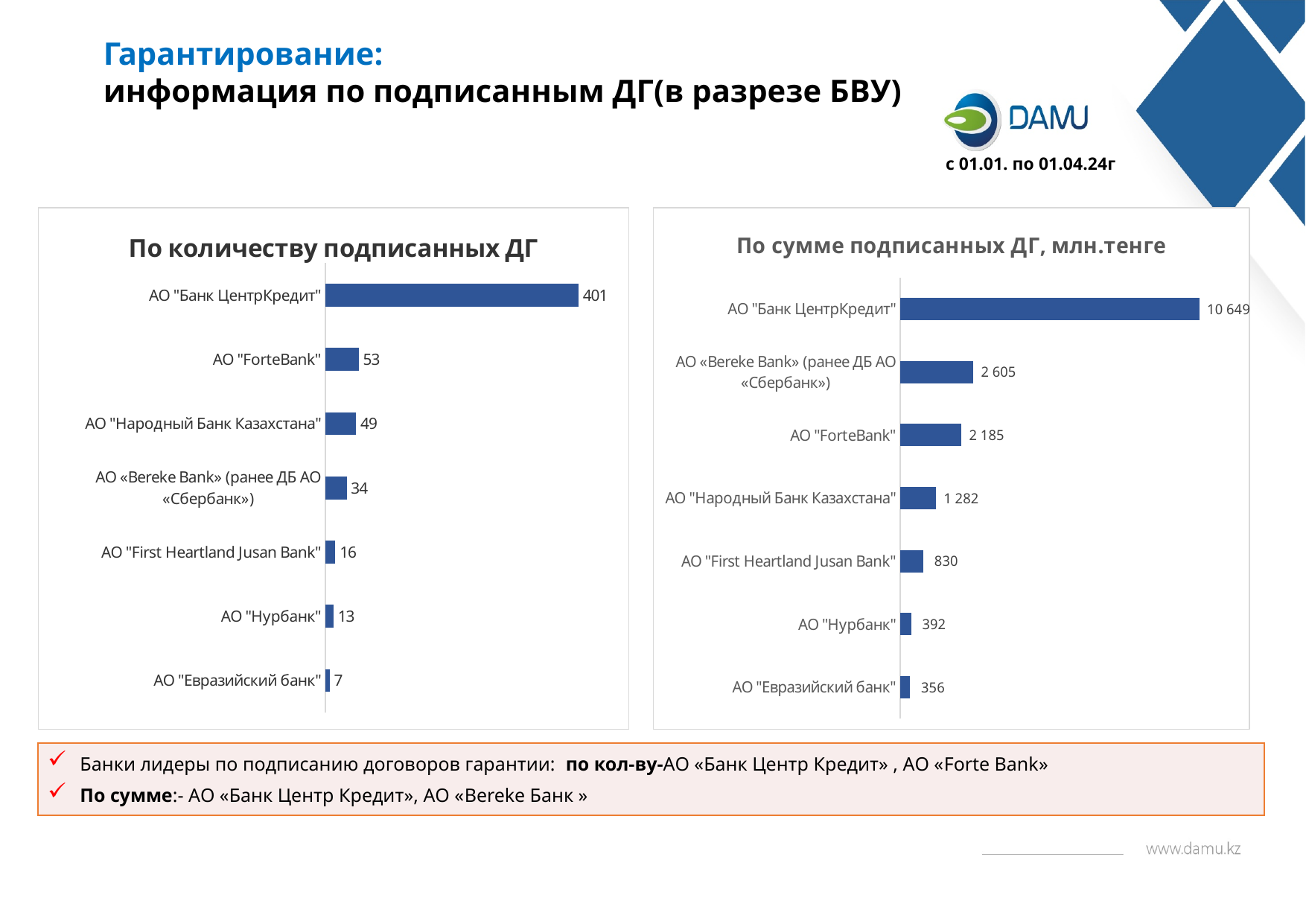
In the chart "По сумме подписанных ДГ, млн.тенге", what is the value for АО «Bereke Bank» (ранее ДБ АО «Сбербанк»)? 2 605 In the chart "По сумме подписанных ДГ, млн.тенге", which is larger: АО "ForteBank" or АО "Народный Банк Казахстана"? АО "ForteBank" In the chart "По сумме подписанных ДГ, млн.тенге", which bank has the highest value? АО "Банк ЦентрКредит" In the chart "По сумме подписанных ДГ, млн.тенге", what is the difference between АО "Нурбанк" and АО "Евразийский банк"? 36 In the chart "По количеству подписанных ДГ", what is the value for АО "Народный Банк Казахстана"? 49 In the chart "По сумме подписанных ДГ, млн.тенге", what is the value for АО "First Heartland Jusan Bank"? 830 What is the title of the chart on the left side of the slide? По количеству подписанных ДГ In the chart "По количеству подписанных ДГ", which bank has the lowest value? АО "Евразийский банк" In the chart "По количеству подписанных ДГ", what is the difference between АО "ForteBank" and АО "Нурбанк"? 40 In the chart "По количеству подписанных ДГ", how many banks are shown? 7 In the chart "По количеству подписанных ДГ", what is the value for АО "Банк ЦентрКредит"? 401 What type of chart is the chart "По сумме подписанных ДГ, млн.тенге"? Bar chart